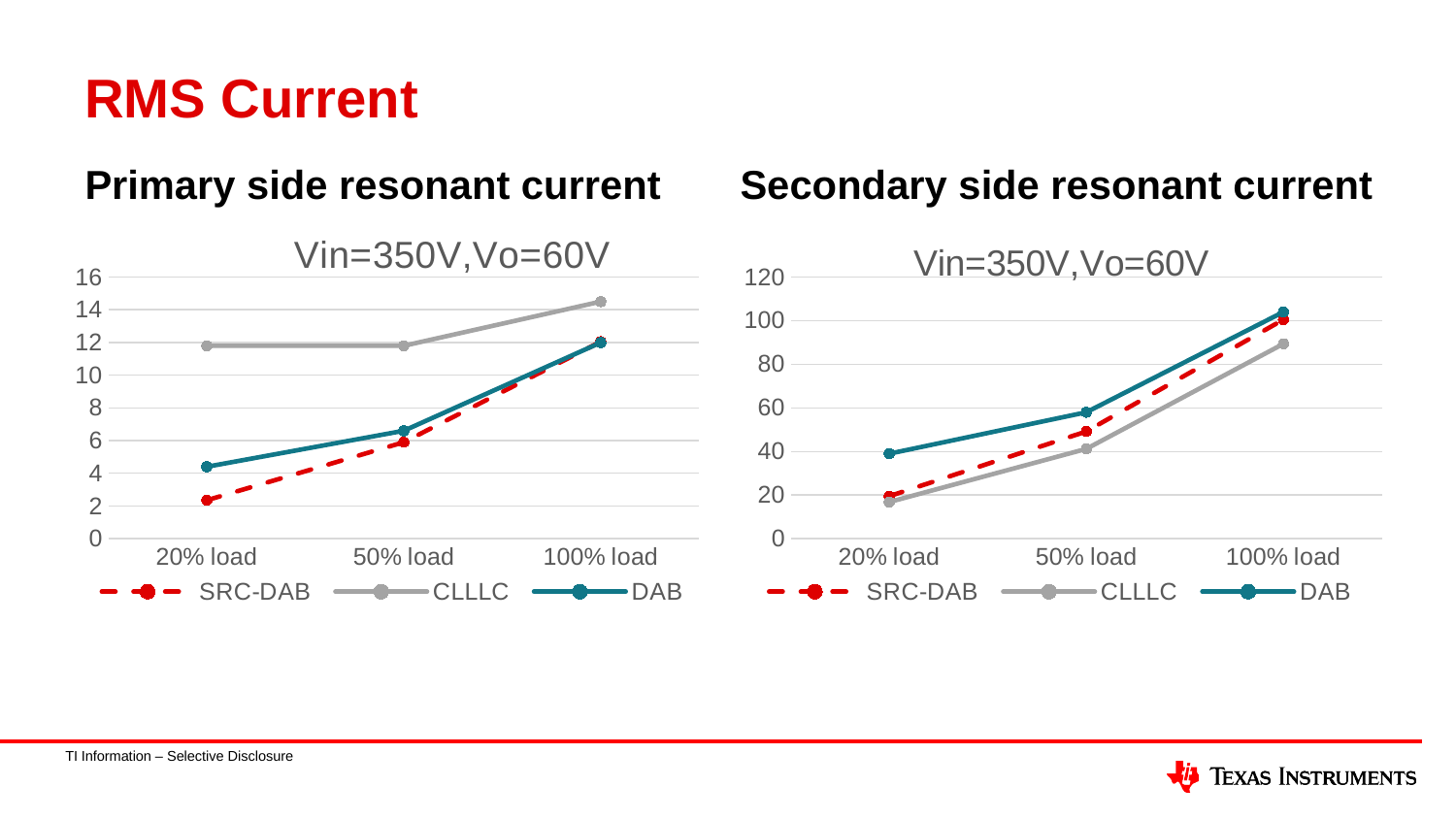
In the Secondary side resonant current chart, is the DAB value at 20% load greater or less than 20? greater How many series does the legend of the Primary side resonant current chart list? 3 In the Primary side resonant current chart, is the CLLLC value at 20% load greater or less than 10? greater In the Primary side resonant current chart, which series has the highest value at 100% load? CLLLC In the Secondary side resonant current chart, which series has the lowest value at 100% load? CLLLC In the Secondary side resonant current chart, which series has the highest value at 20% load? DAB How many load categories are shown on the x axis of the Secondary side resonant current chart? 3 In the Primary side resonant current chart, which is larger at 20% load, DAB or SRC-DAB? DAB In the Primary side resonant current chart, is the SRC-DAB value at 20% load greater or less than 4? less What kind of chart is the Primary side resonant current chart? line chart In the Primary side resonant current chart, does the SRC-DAB series rise or fall from 20% load to 100% load? rise What is the title shown inside the Secondary side resonant current chart? Vin=350V,Vo=60V